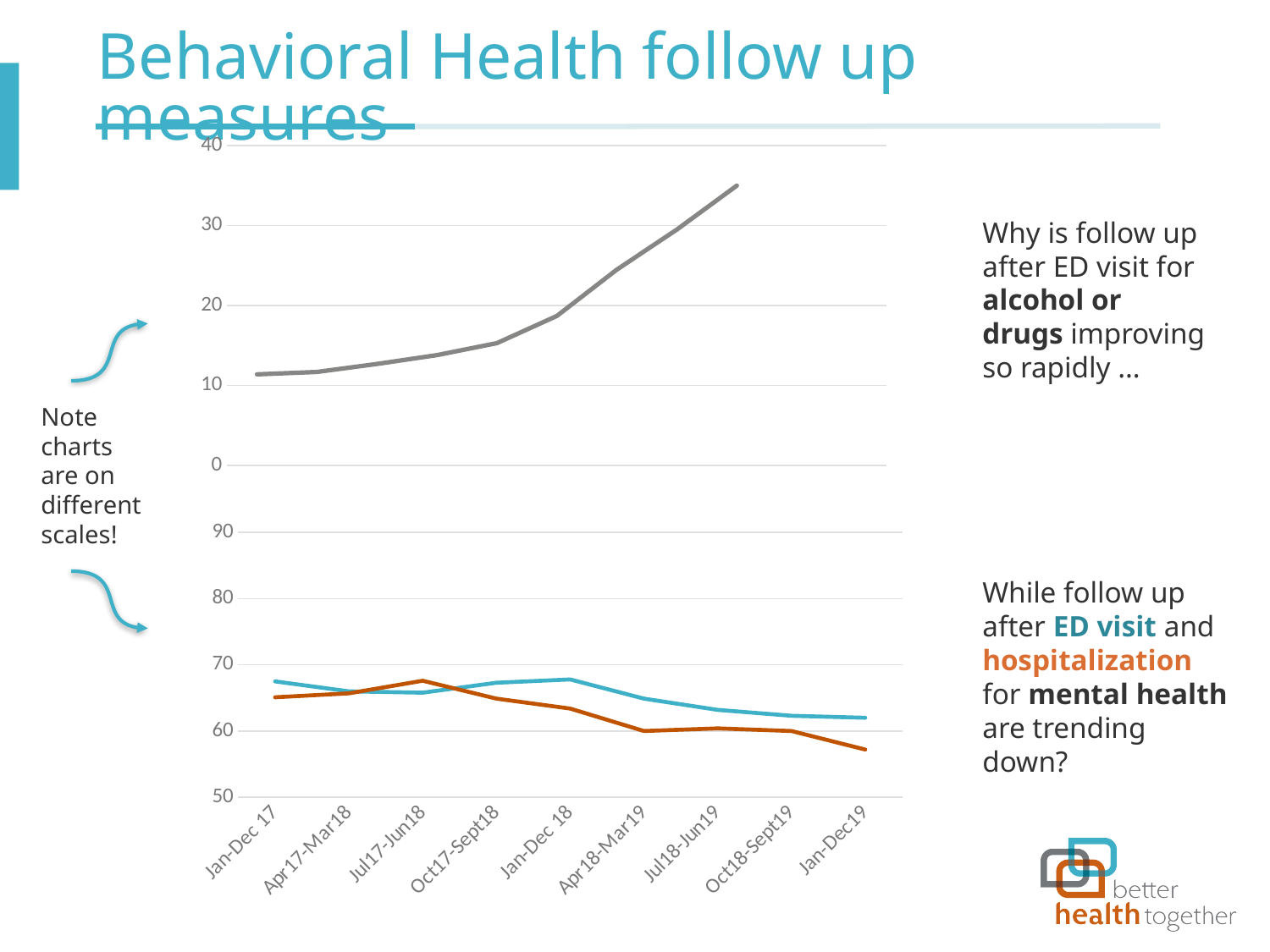
In the bottom chart, at which period does the orange line reach its highest value? Jul17-Jun18 In the bottom chart, which line is higher at Jan-Dec19, the blue line or the orange line? blue line What kind of chart is the bottom chart on the slide? line chart How many lines are plotted in the bottom chart? 2 How many time-period categories are labelled on the x axis of the bottom chart? 9 In the bottom chart, do the blue and orange lines trend up or down overall from Jan-Dec 17 to Jan-Dec19? down In the bottom chart, is the orange line's value for Jan-Dec19 greater or less than 60? less What kind of chart is the top chart on the slide? line chart In the bottom chart, is the blue line's value for Jan-Dec19 greater or less than 60? greater